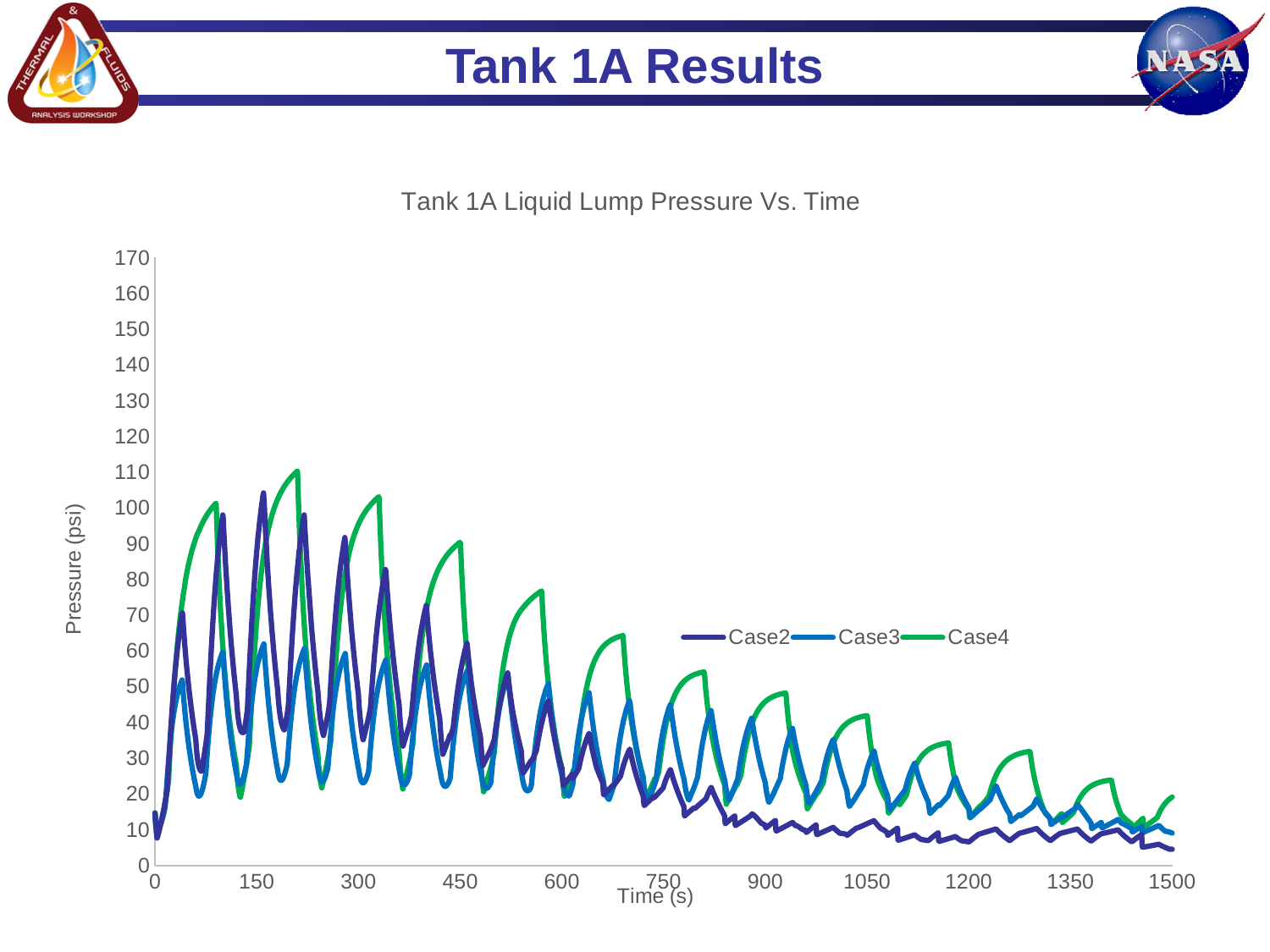
What is the label of the vertical axis? Pressure (psi) Which series has the lowest peak pressure? Case3 Is the highest peak of the Case4 line greater or less than 100? greater Do the peak pressures rise or fall as time increases beyond 300 s? fall What kind of chart is shown on the slide? line chart Is the value of Case4 at 1500 s greater or less than 10? greater Which series has the highest value at 1500 s? Case4 How many series does the legend list? 3 At 1500 s, which is larger, the Case3 value or the Case2 value? Case3 What is the title of the chart? Tank 1A Liquid Lump Pressure Vs. Time Is the value of Case2 at 1500 s greater or less than 10? less